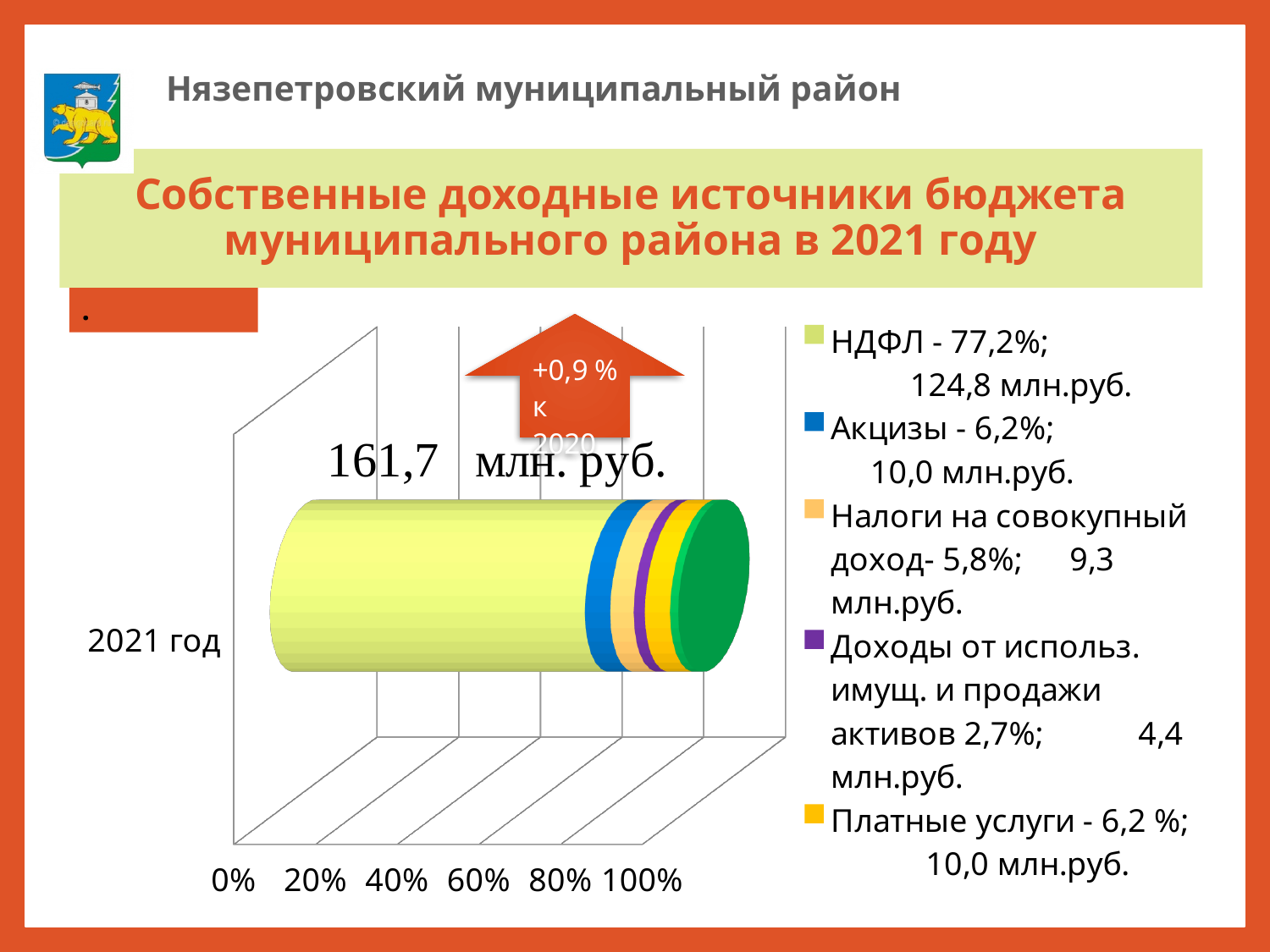
What is the amount of НДФЛ revenue in 2021 according to the legend? 124,8 млн.руб. Which revenue source has the largest share in 2021? НДФЛ What total amount of own revenue is labelled above the bar for 2021? 161,7 млн. руб. Which is larger: the share of Акцизы or the share of Налоги на совокупный доход? Акцизы How many categories are shown on the category axis of the chart? 1 What share do Акцизы account for in 2021? 6,2% How many series does the legend list? 5 What share of own budget revenue does НДФЛ account for in 2021? 77,2% What is the amount for Доходы от использ. имущ. и продажи активов? 4,4 млн.руб. What kind of chart is shown on the slide? bar chart By how many million rubles does НДФЛ exceed Акцизы? 114,8 млн.руб.